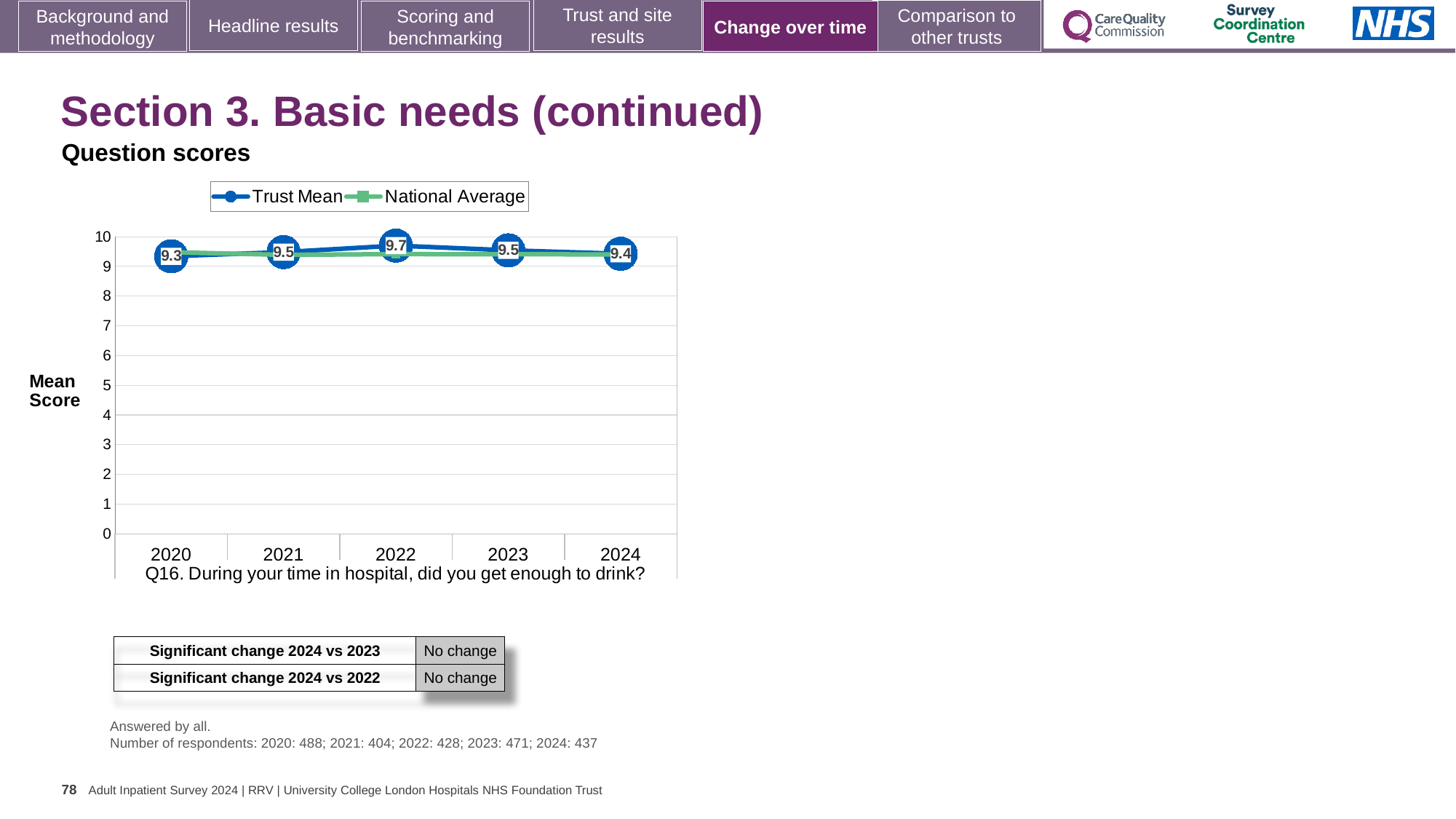
Which year has the larger Trust Mean score, 2021 or 2024? 2021 How many years are shown on the x axis of the chart? 5 In which year is the Trust Mean score highest? 2022 What is the Trust Mean score for 2024? 9.4 How many series does the chart legend list? 2 What kind of chart is shown on the slide? Line chart What is the Trust Mean score for 2020? 9.3 In which year is the Trust Mean score lowest? 2020 What is the Trust Mean score for 2022? 9.7 Which question does the chart relate to, as shown below the x axis? Q16. During your time in hospital, did you get enough to drink? Is the National Average value for 2024 greater or less than 8? greater What is the difference between the Trust Mean scores for 2022 and 2020? 0.4